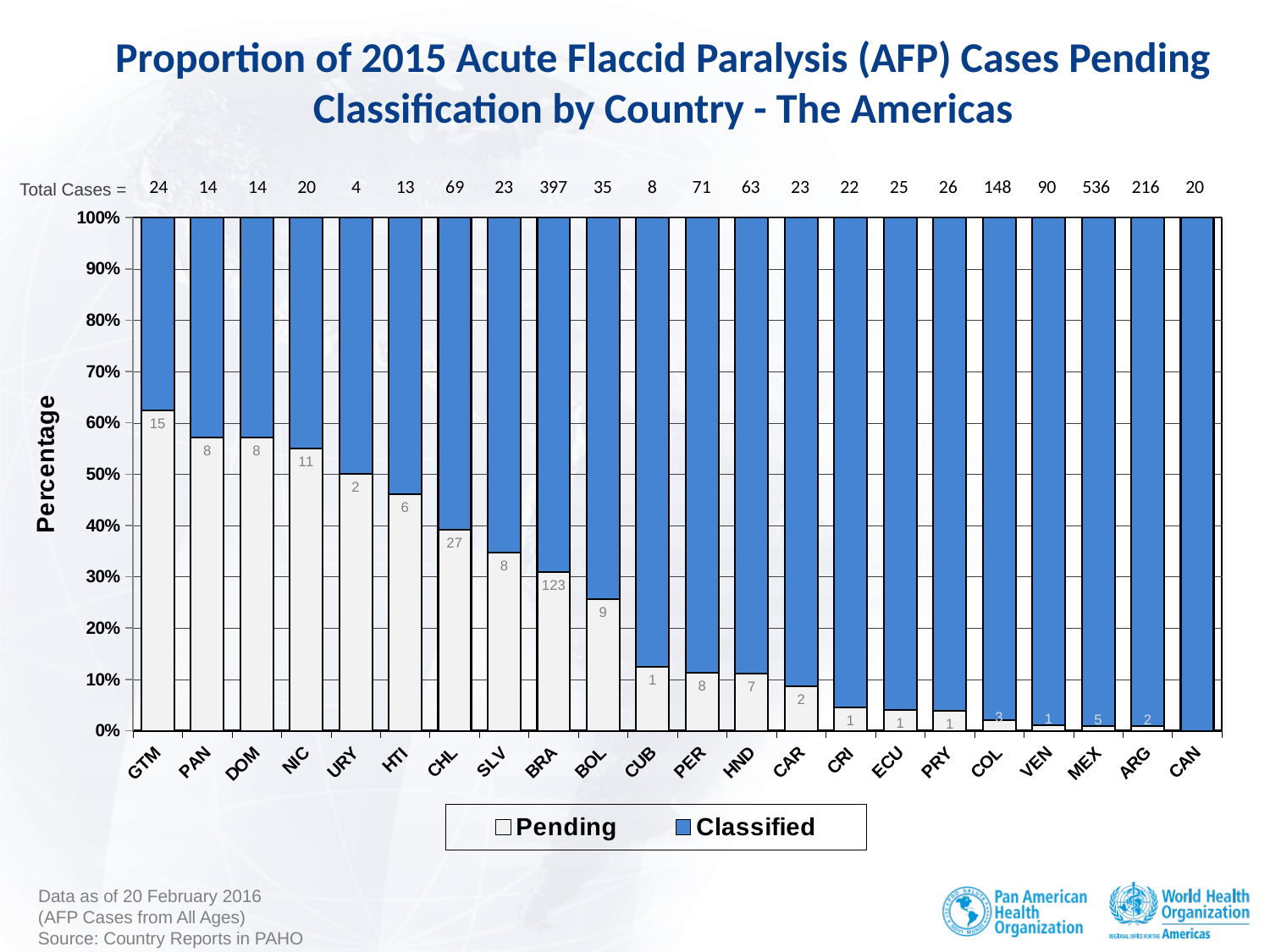
What kind of chart is shown on the slide? stacked bar chart Which has more pending cases labelled on its bar, BRA or CHL? BRA How many countries are shown along the x axis? 22 Is the pending percentage for GTM greater or less than 50%? greater How many series does the legend list? 2 What is the difference between the total cases for MEX and ARG? 320 What is the total number of cases shown for MEX? 536 What is the number of pending cases labelled on the bar for BRA? 123 Which country has the smallest total number of cases? URY Does the pending share of cases rise or fall moving from left to right along the x axis? fall Which country has the largest total number of cases? MEX What is the number of pending cases labelled on the bar for GTM? 15